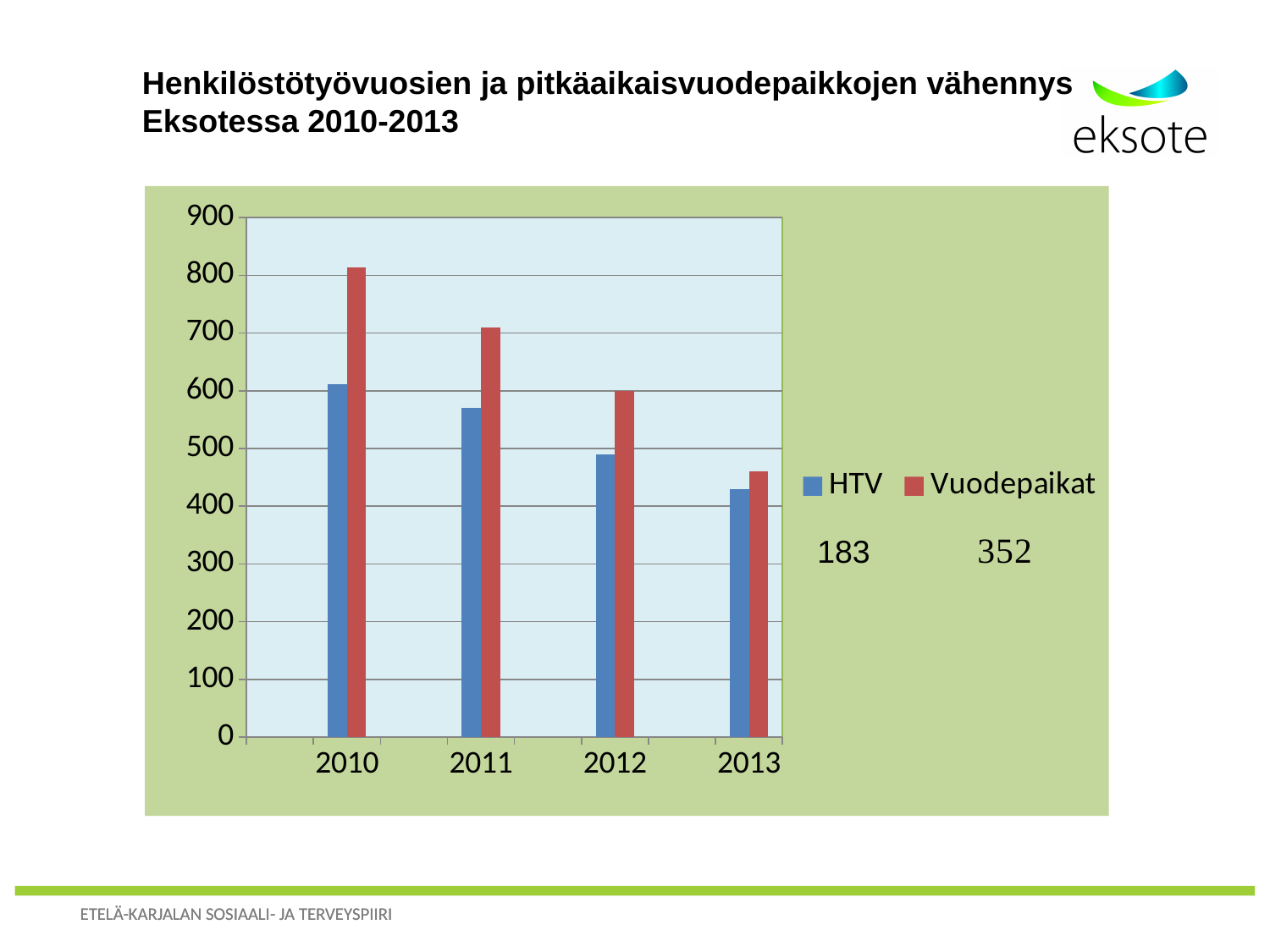
Do the HTV values rise or fall from 2010 to 2013? fall What kind of chart is shown on the slide? bar chart Is the Vuodepaikat value for 2010 greater or less than 800? greater Which year has the highest Vuodepaikat value? 2010 In 2012, which is larger, HTV or Vuodepaikat? Vuodepaikat Which year has the lowest HTV value? 2013 How many series does the legend list? 2 What are the two series named in the legend? HTV and Vuodepaikat Which colour represents the Vuodepaikat series? red Is the HTV value for 2013 greater or less than 500? less How many years are shown on the x axis? 4